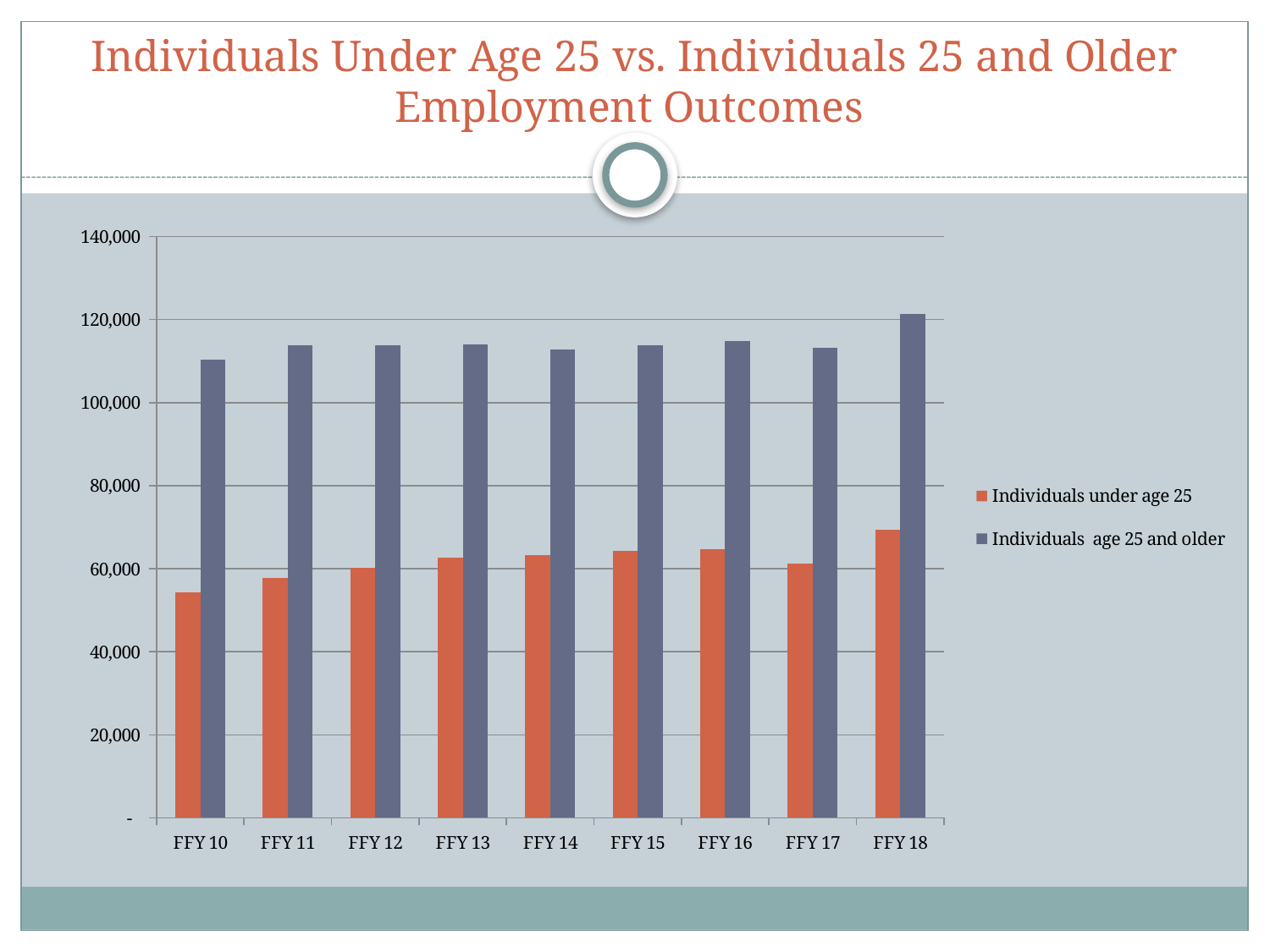
Which colour represents Individuals under age 25 in the chart? orange Is the value for Individuals under age 25 in FFY 10 greater or less than 60,000? less In which fiscal year is the value for Individuals age 25 and older highest? FFY 18 Is the value for Individuals under age 25 in FFY 18 greater or less than 60,000? greater Which is larger in FFY 14: the value for Individuals under age 25 or the value for Individuals age 25 and older? Individuals age 25 and older How many fiscal year categories are shown on the x axis? 9 Does the value for Individuals under age 25 rise or fall from FFY 10 to FFY 13? rise In which fiscal year is the value for Individuals under age 25 lowest? FFY 10 What kind of chart is shown on the slide? bar chart How many series does the legend list? 2 Is the value for Individuals age 25 and older in FFY 10 greater or less than 100,000? greater In which fiscal year is the value for Individuals under age 25 highest? FFY 18